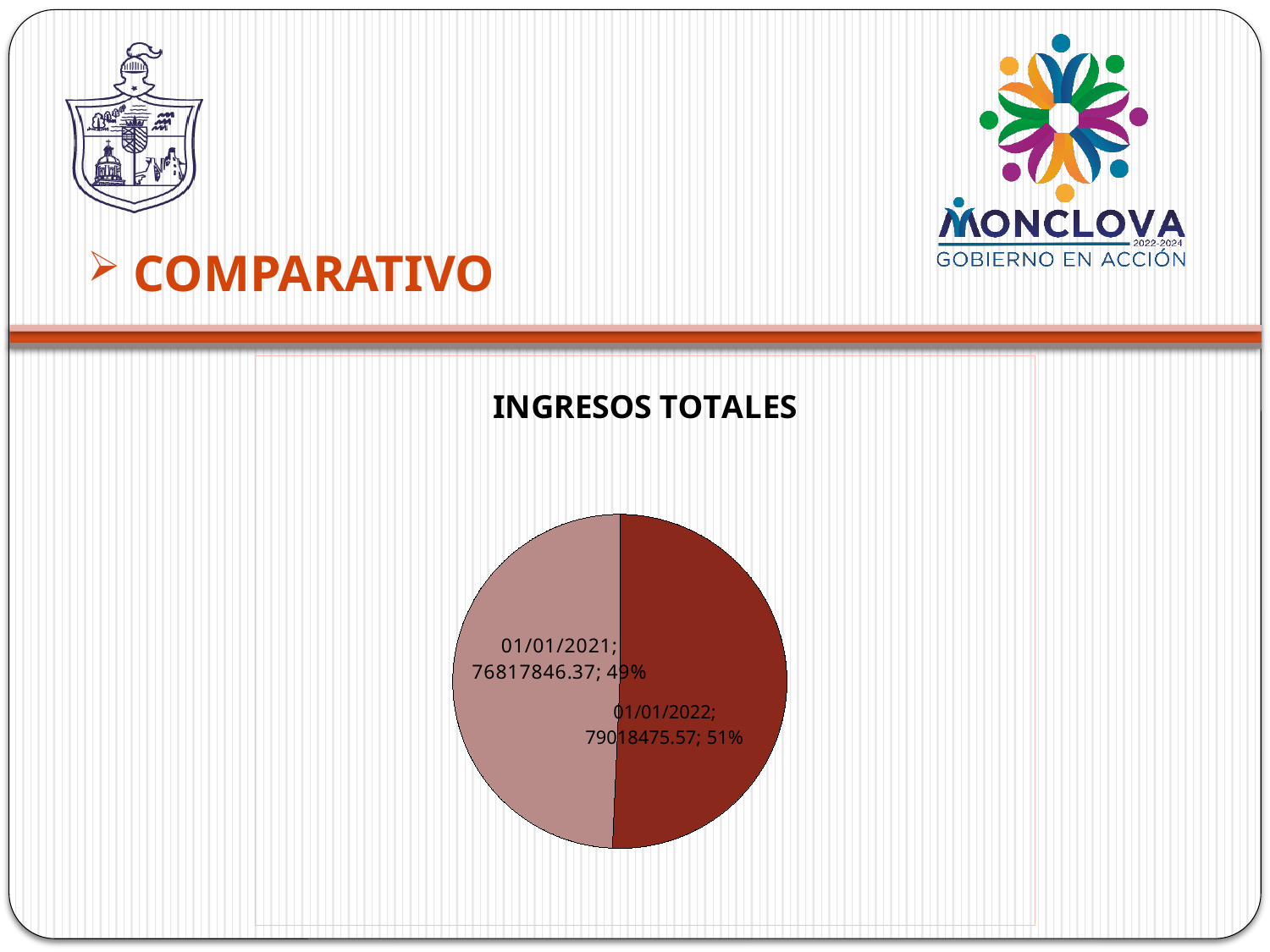
Which category has the smallest share of the pie? 01/01/2021 What share of the pie does the 01/01/2021 slice represent? 49% What type of chart is shown under the title INGRESOS TOTALES? pie chart Which slice is larger, 01/01/2021 or 01/01/2022? 01/01/2022 What share of the pie does the 01/01/2022 slice represent? 51% What is the difference between the values for 01/01/2022 and 01/01/2021? 2200629.20 What is the title of the chart? INGRESOS TOTALES What is the value shown for 01/01/2022? 79018475.57 What is the value shown for 01/01/2021? 76817846.37 Which slice is drawn in the darker red colour? 01/01/2022 What is the total of the two values shown in the pie chart? 155836321.94 How many slices does the pie chart have? 2